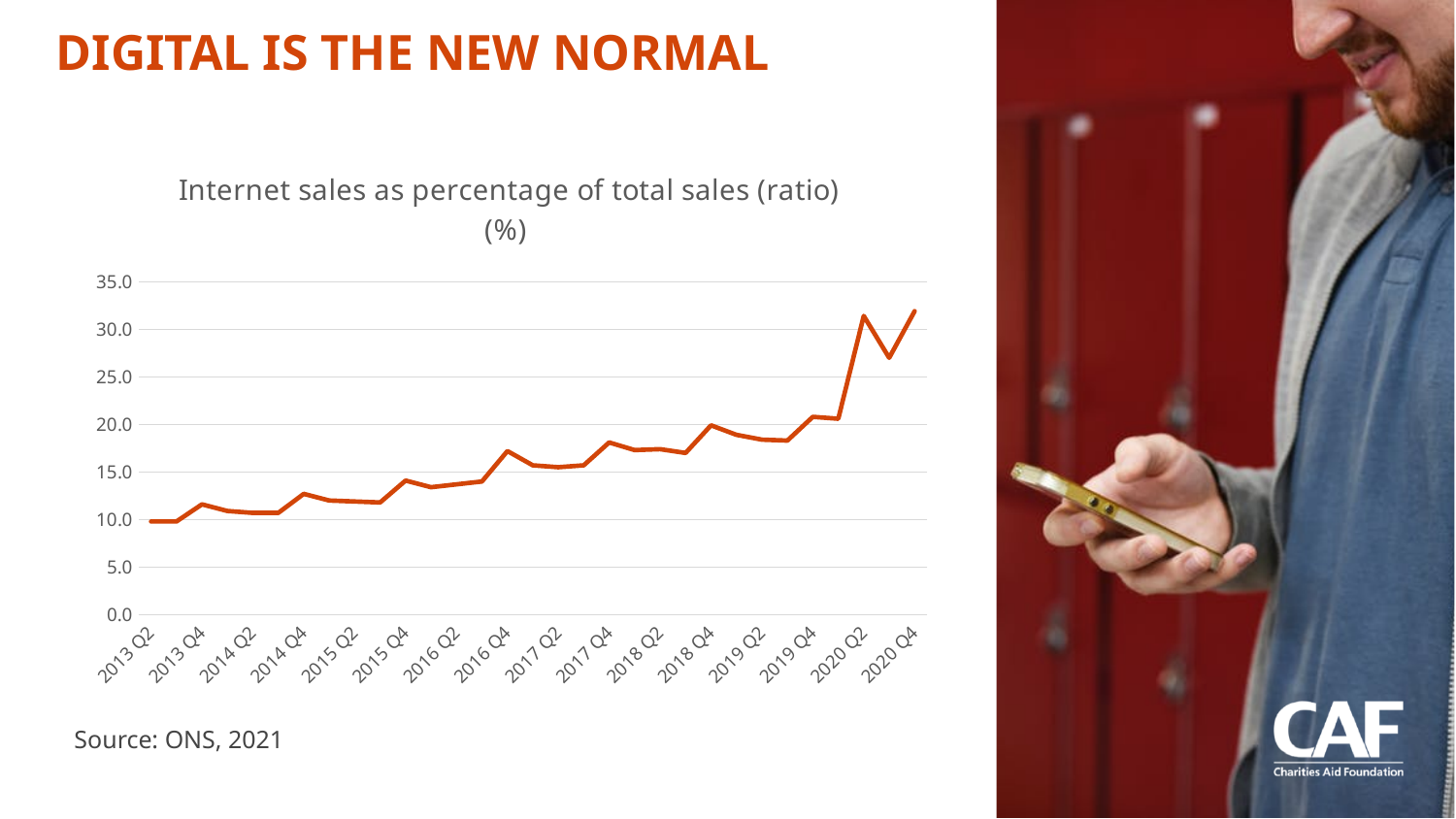
Is the value for 2013 Q2 greater or less than 15.0? less Is the value for 2016 Q4 greater or less than 15.0? greater Is the value for 2015 Q4 greater or less than 15.0? less What source is cited for the chart data? ONS, 2021 Do the values generally rise or fall from 2013 Q2 to 2020 Q4? rise Which is larger, the value for 2016 Q4 or the value for 2015 Q4? 2016 Q4 Which is larger, the value for 2020 Q2 or the value for 2019 Q4? 2020 Q2 What is the title of the chart? Internet sales as percentage of total sales (ratio) (%) What kind of chart is shown on the slide? line chart